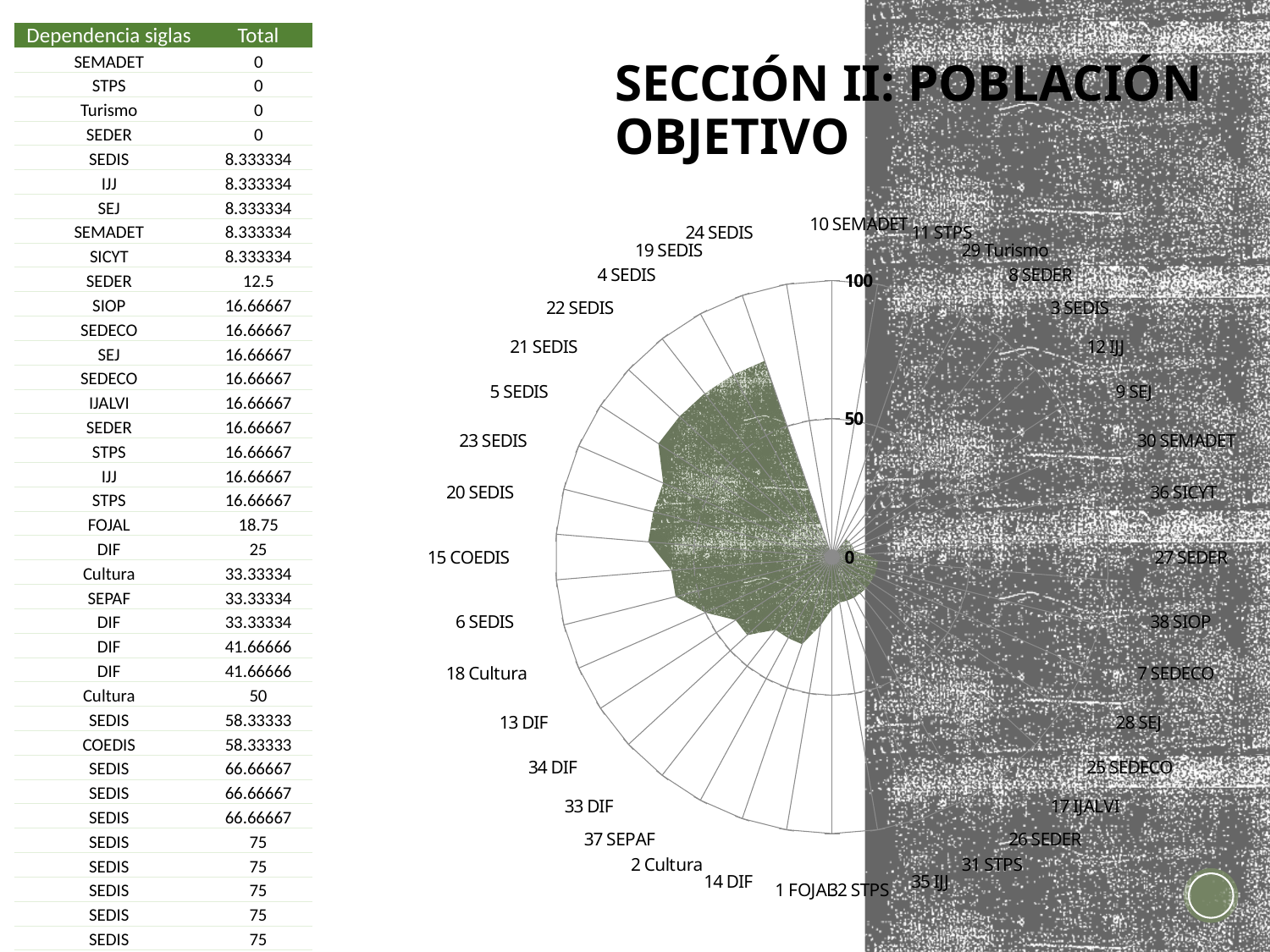
What is the highest value shown on the chart's radial axis? 100 Is the value for 20 SEDIS greater or less than 50? greater Which is larger, the value for 4 SEDIS or the value for 2 Cultura? 4 SEDIS Is the value for 15 COEDIS greater or less than 50? greater Is the value for 24 SEDIS greater or less than 50? greater What kind of chart is shown on the slide? Radar chart Which is larger, the value for 24 SEDIS or the value for 10 SEMADET? 24 SEDIS What is the title of the slide containing the chart? SECCIÓN II: POBLACIÓN OBJETIVO